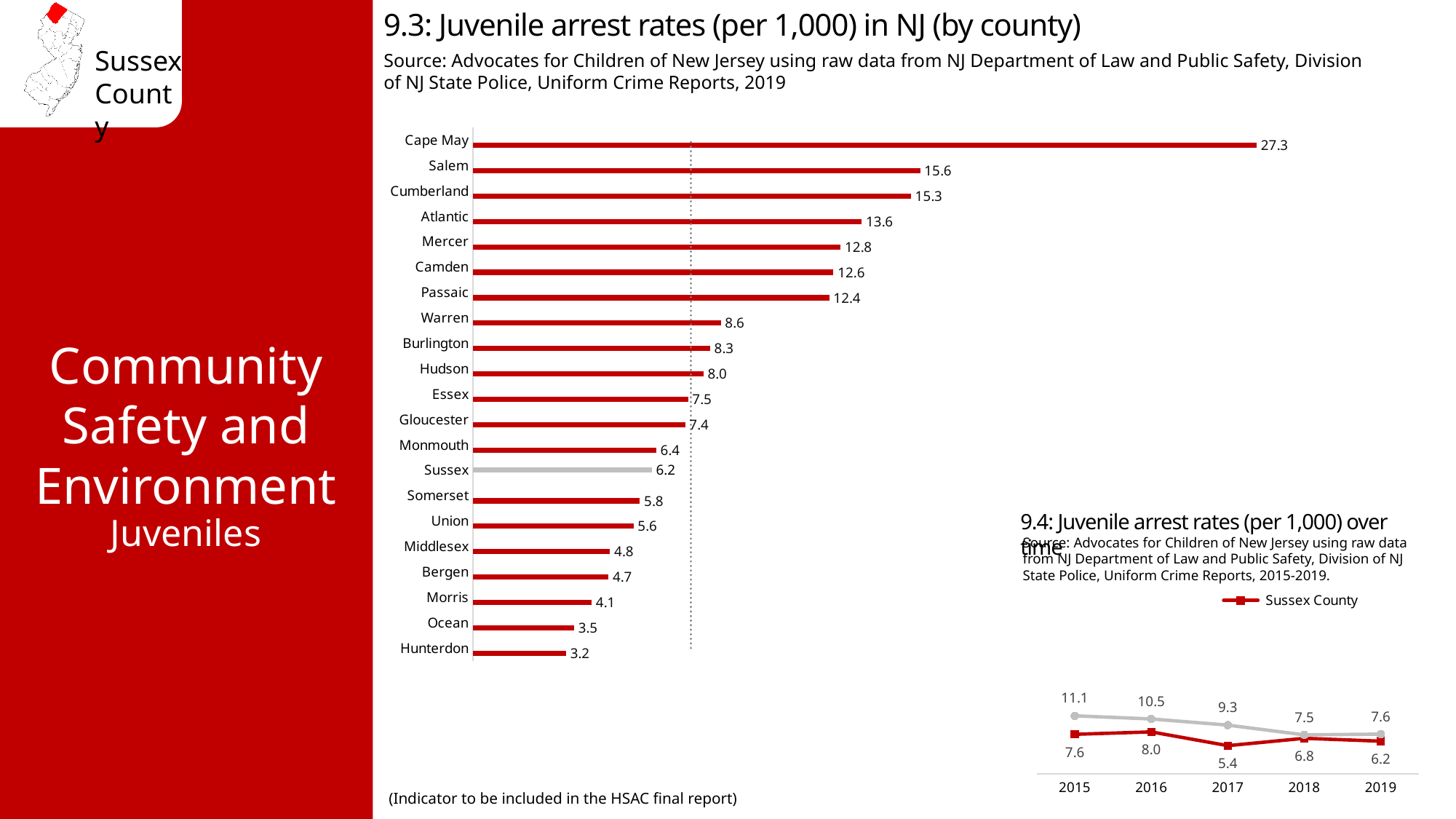
In chart 9.3 (juvenile arrest rates by county), which county has the lowest juvenile arrest rate? Hunterdon In chart 9.3 (juvenile arrest rates by county), how many counties are shown? 21 In chart 9.4 (juvenile arrest rates over time), in which year is the Sussex County value highest? 2016 In chart 9.3 (juvenile arrest rates by county), what is the value for Cape May? 27.3 What kind of chart is chart 9.3 (juvenile arrest rates by county)? Bar chart In chart 9.3 (juvenile arrest rates by county), what is the value for Sussex? 6.2 In chart 9.3 (juvenile arrest rates by county), which has a higher value, Warren or Monmouth? Warren In chart 9.3 (juvenile arrest rates by county), which county has the highest juvenile arrest rate? Cape May In chart 9.3 (juvenile arrest rates by county), which bar is shown in gray instead of red? Sussex In chart 9.3 (juvenile arrest rates by county), what is the difference between the values for Salem and Cumberland? 0.3 In chart 9.4 (juvenile arrest rates over time), what is the difference between the Sussex County values for 2015 and 2019? 1.4 In chart 9.4 (juvenile arrest rates over time), what is the Sussex County value for 2017? 5.4